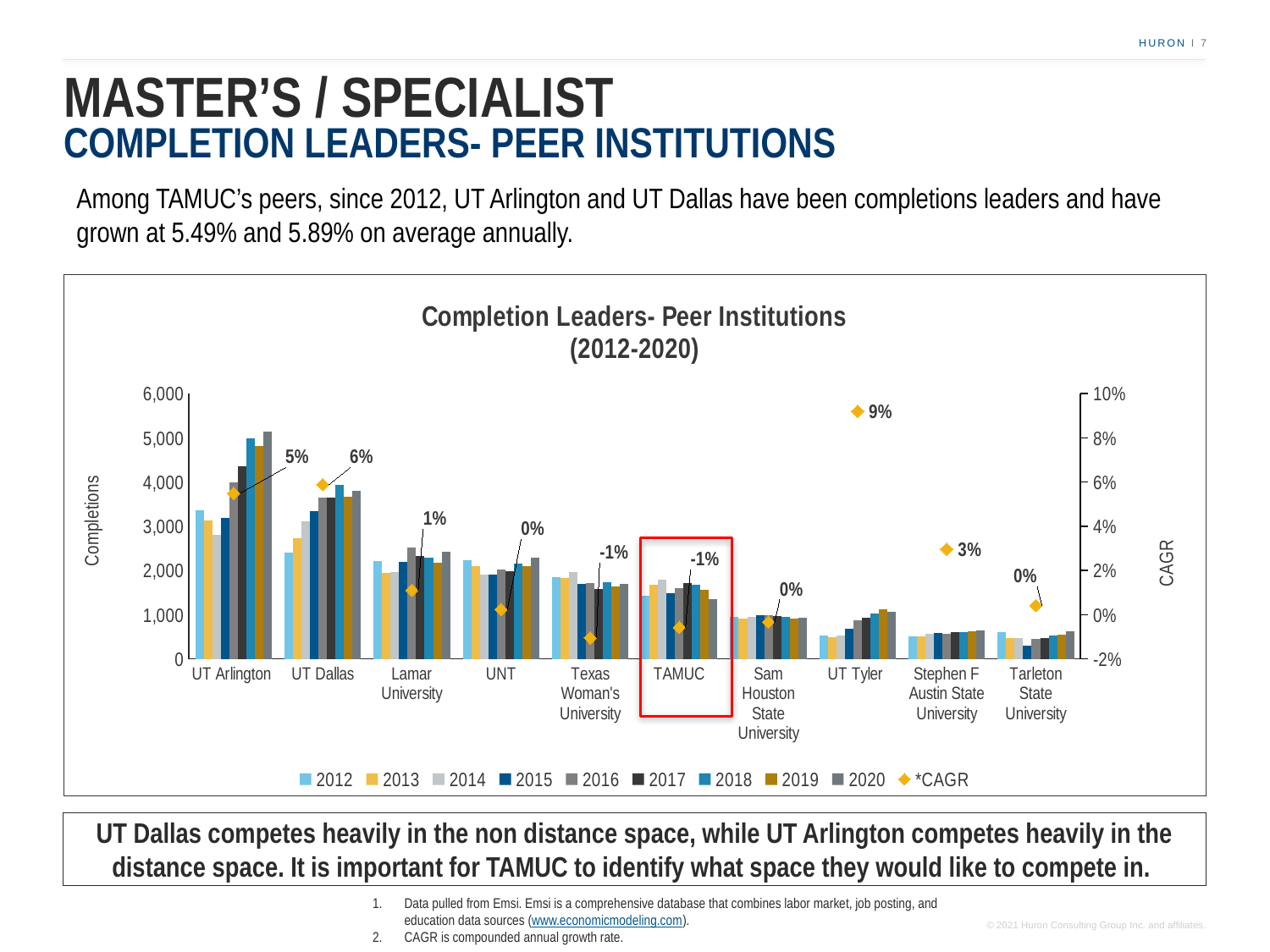
Which institution has more completions in 2020, UT Arlington or UT Dallas? UT Arlington Which institution on the chart is highlighted with a red box? TAMUC How many entries does the chart's legend list? 10 How many institutions are shown on the x axis of the chart? 10 What is the CAGR value labelled for UT Tyler? 9% What is the difference between the CAGR labels for UT Tyler and Stephen F Austin State University? 6% Is the 2020 completions value for UT Arlington greater or less than 4,000? greater What is the CAGR value labelled for TAMUC? -1% Is the 2012 completions value for TAMUC greater or less than 2,000? less What kind of chart is shown on the slide? Combination chart (bars for completions with diamond markers for CAGR) What is the CAGR value labelled for UT Dallas? 6% Which institution has the highest CAGR label on the chart? UT Tyler